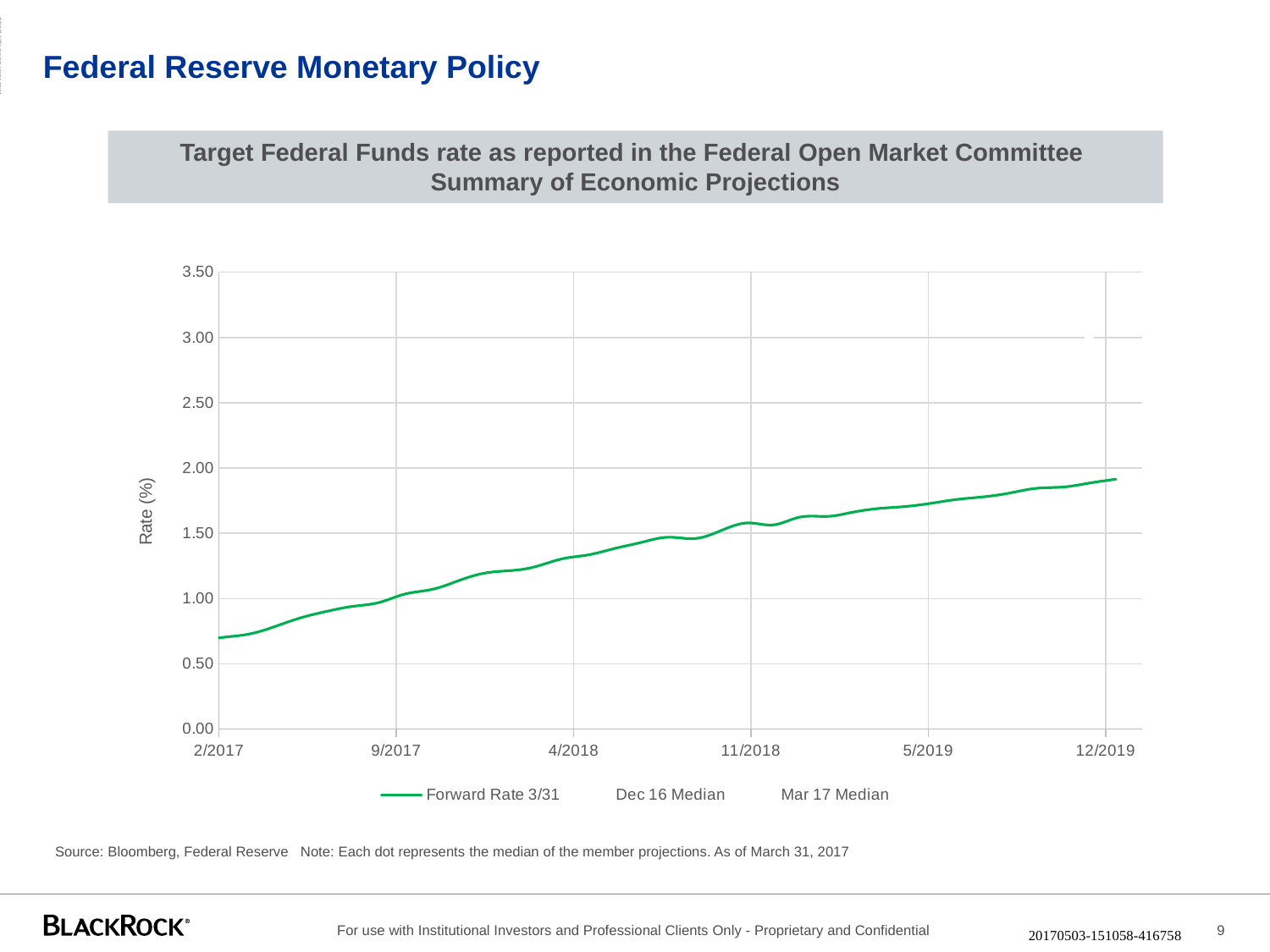
Is the Forward Rate 3/31 value at 12/2019 greater or less than 1.50? greater What kind of chart is shown on the slide? line chart What is the title of the chart? Target Federal Funds rate as reported in the Federal Open Market Committee Summary of Economic Projections Is the Forward Rate 3/31 value at 12/2019 greater or less than 2.00? less Which is larger for the Forward Rate 3/31 line, the value at 2/2017 or the value at 12/2019? 12/2019 Is the Forward Rate 3/31 value at 5/2019 greater or less than 1.50? greater At which x-axis date is the Forward Rate 3/31 line at its highest? 12/2019 How many series does the legend list? 3 What is the label of the y axis? Rate (%) Does the Forward Rate 3/31 line rise or fall from 2/2017 to 12/2019? rise